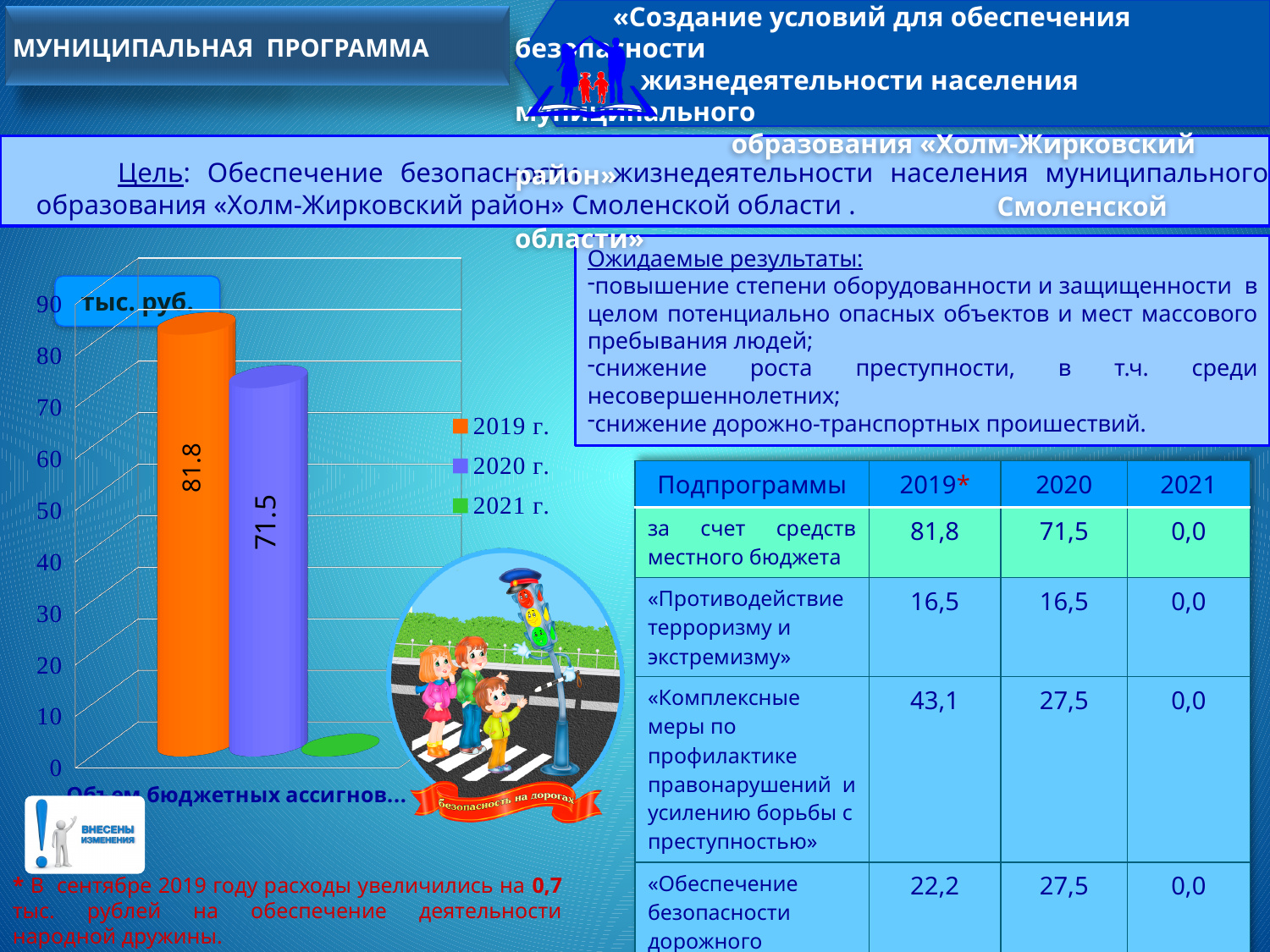
What kind of chart is shown on the slide? bar chart What is the difference between the 2019 г. and 2020 г. values in the chart? 10.3 What is the value of the 2020 г. bar in the chart? 71.5 Do the values in the chart rise or fall from 2019 г. to 2021 г.? fall Which year has the lowest value in the chart? 2021 г. What is the value of the 2019 г. bar in the chart? 81.8 Is the value for 2019 г. greater or less than 80? greater Which is larger in the chart, the 2019 г. value or the 2020 г. value? 2019 г. Which year has the highest bar in the chart? 2019 г. How many series does the chart legend list? 3 Is the value for 2020 г. greater or less than 80? less What unit label is shown at the top of the chart? тыс. руб.